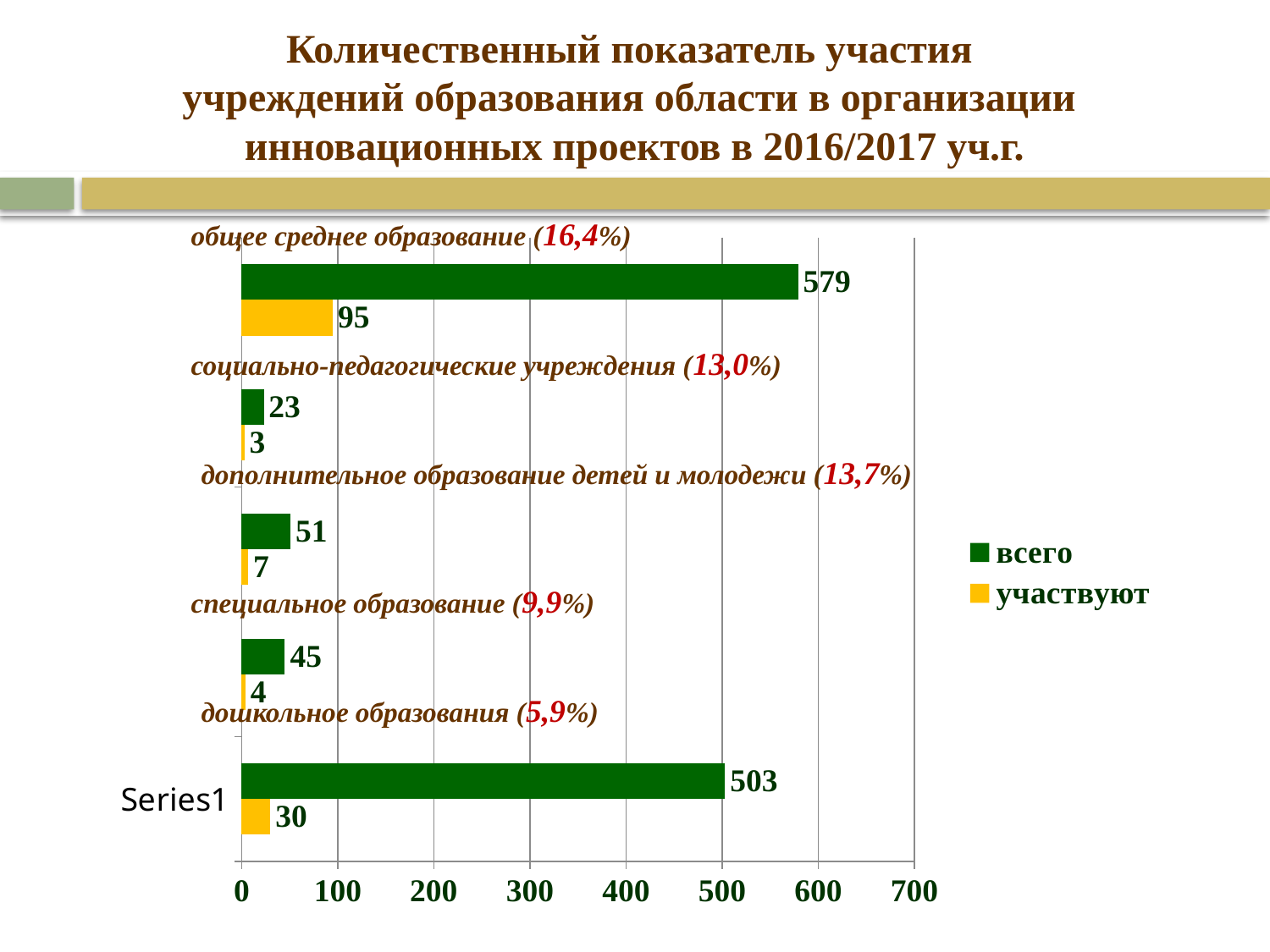
What colour represents the 'участвуют' series? yellow Which category has the highest 'всего' value? общее среднее образование What is the value of the 'всего' series for 'общее среднее образование'? 579 Is the 'всего' value for 'дошкольное образования' greater or less than 400? greater Which is larger: the 'всего' value for 'специальное образование' or for 'дополнительное образование детей и молодежи'? дополнительное образование детей и молодежи How many series does the legend list? 2 Which category has the lowest 'участвуют' value? социально-педагогические учреждения What is the difference between the 'всего' and 'участвуют' values for 'общее среднее образование'? 484 What is the value of the 'участвуют' series for 'дошкольное образования'? 30 What is the value of the 'участвуют' series for 'социально-педагогические учреждения'? 3 What is the value of the 'всего' series for 'дополнительное образование детей и молодежи'? 51 What kind of chart is shown on the slide? bar chart